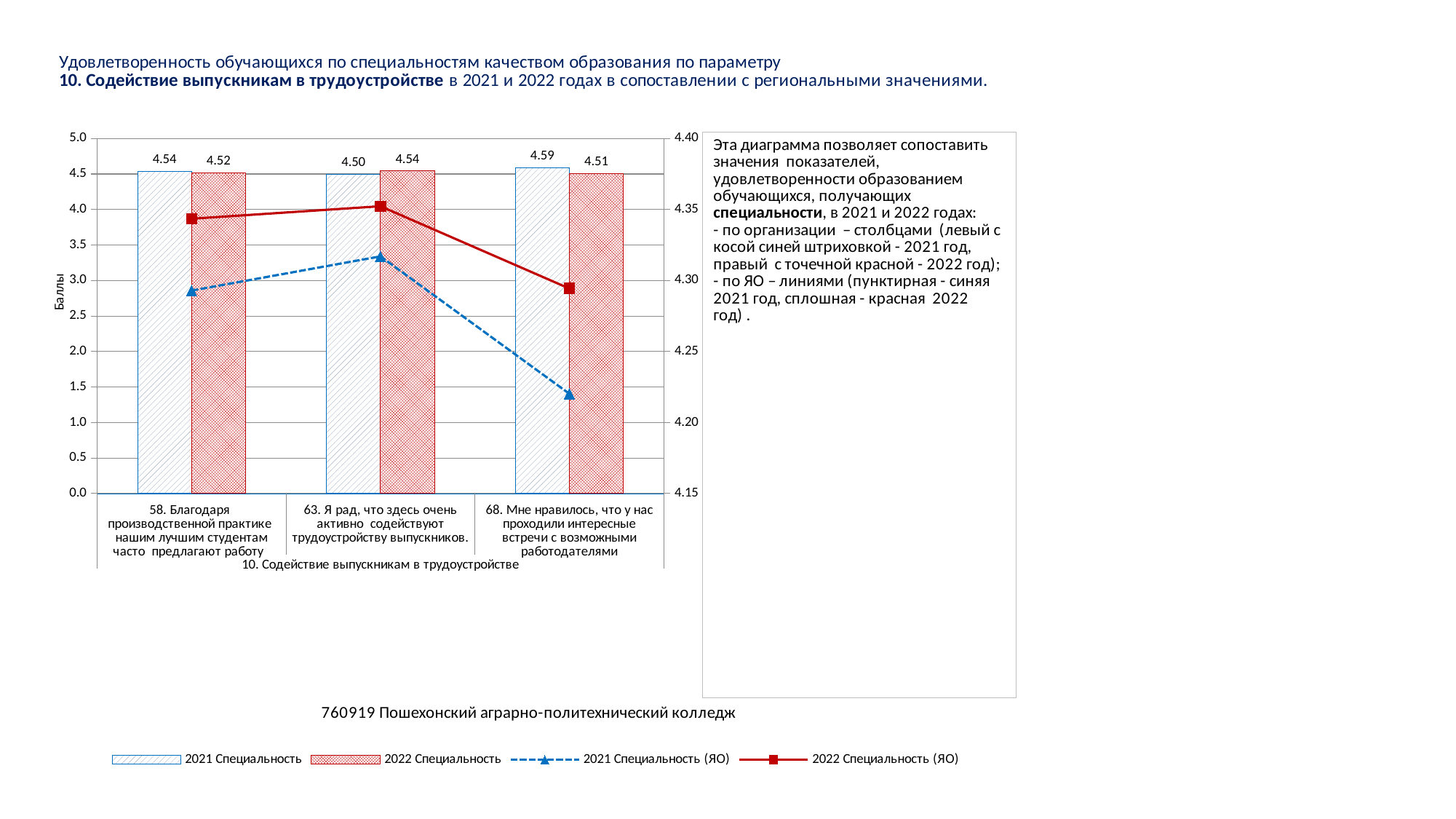
What is the value of the 2022 Специальность bar for item 68 (Мне нравилось, что у нас проходили интересные встречи с возможными работодателями)? 4.51 What is the value of the 2021 Специальность bar for item 58 (Благодаря производственной практике нашим лучшим студентам часто предлагают работу)? 4.54 Which item has the highest 2021 Специальность bar? 68. Мне нравилось, что у нас проходили интересные встречи с возможными работодателями Is the 2022 Специальность (ЯО) value for item 58 greater or less than 4.30 on the right axis? greater Which item has the lowest 2021 Специальность bar? 63. Я рад, что здесь очень активно содействуют трудоустройству выпускников How many series does the legend list? 4 What is the value of the 2022 Специальность bar for item 63 (Я рад, что здесь очень активно содействуют трудоустройству выпускников)? 4.54 For item 63, which is larger: the 2021 Специальность bar or the 2022 Специальность bar? 2022 Специальность How many items (categories) are shown on the x axis? 3 Is the 2021 Специальность (ЯО) value for item 68 greater or less than 4.25 on the right axis? less What is the difference between the 2021 and 2022 Специальность bars for item 68? 0.08 What kind of chart is shown on the slide? Combined bar and line chart